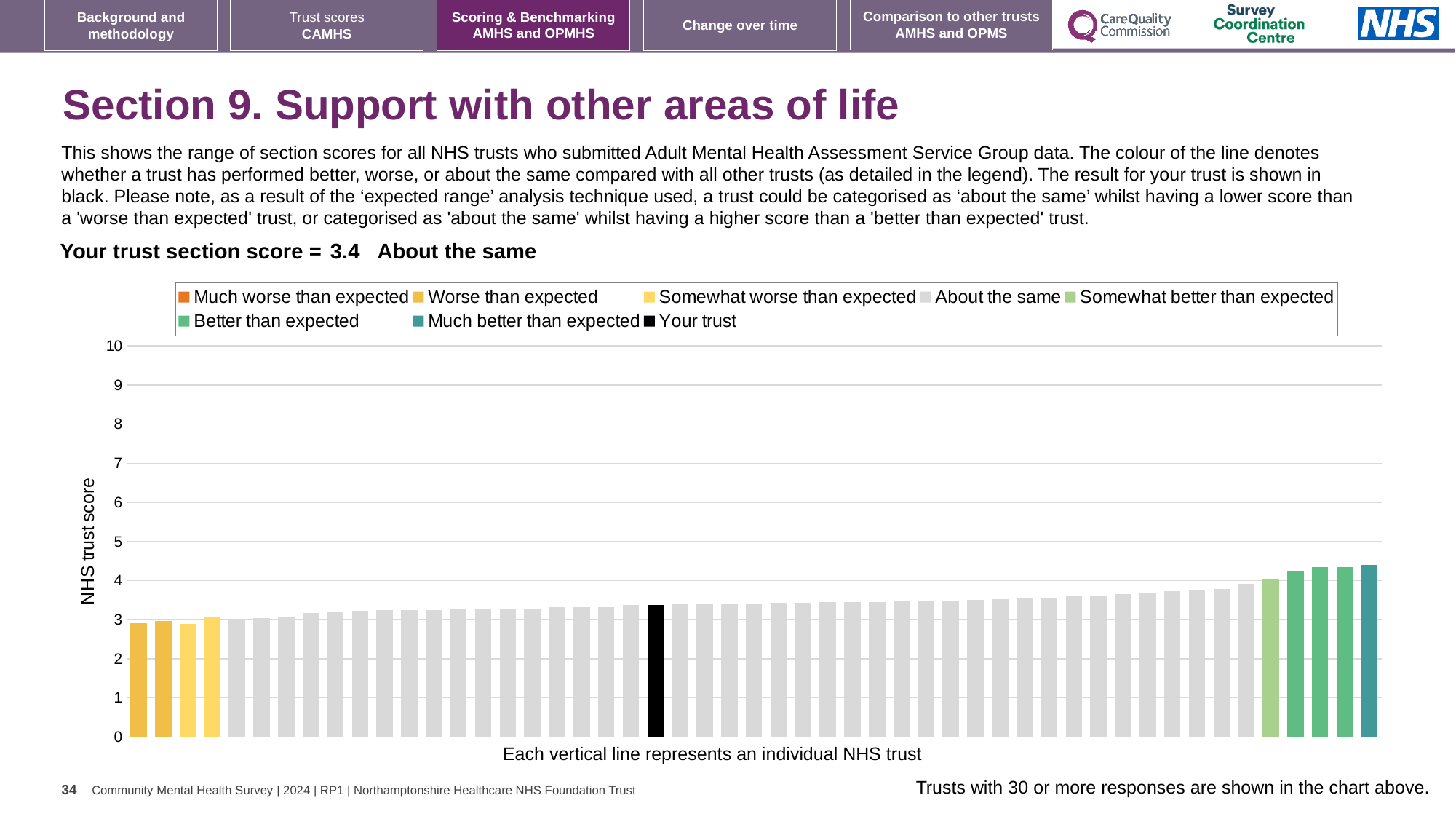
How many bars are coloured as 'Much better than expected'? 1 Is the value of the black 'Your trust' bar greater or less than 3? greater Do the bar values rise or fall from left to right along the x axis? rise Is the value of the tallest bar greater or less than 4? greater Is the value of the tallest bar greater or less than 5? less Which legend category does your trust fall into? About the same What kind of chart is shown on the slide? bar chart What is the label on the y axis of the chart? NHS trust score How many bars are coloured as 'Better than expected'? 3 Which legend category does the tallest bar belong to? Much better than expected What is the section score for your trust? 3.4 How many entries does the chart legend list? 8